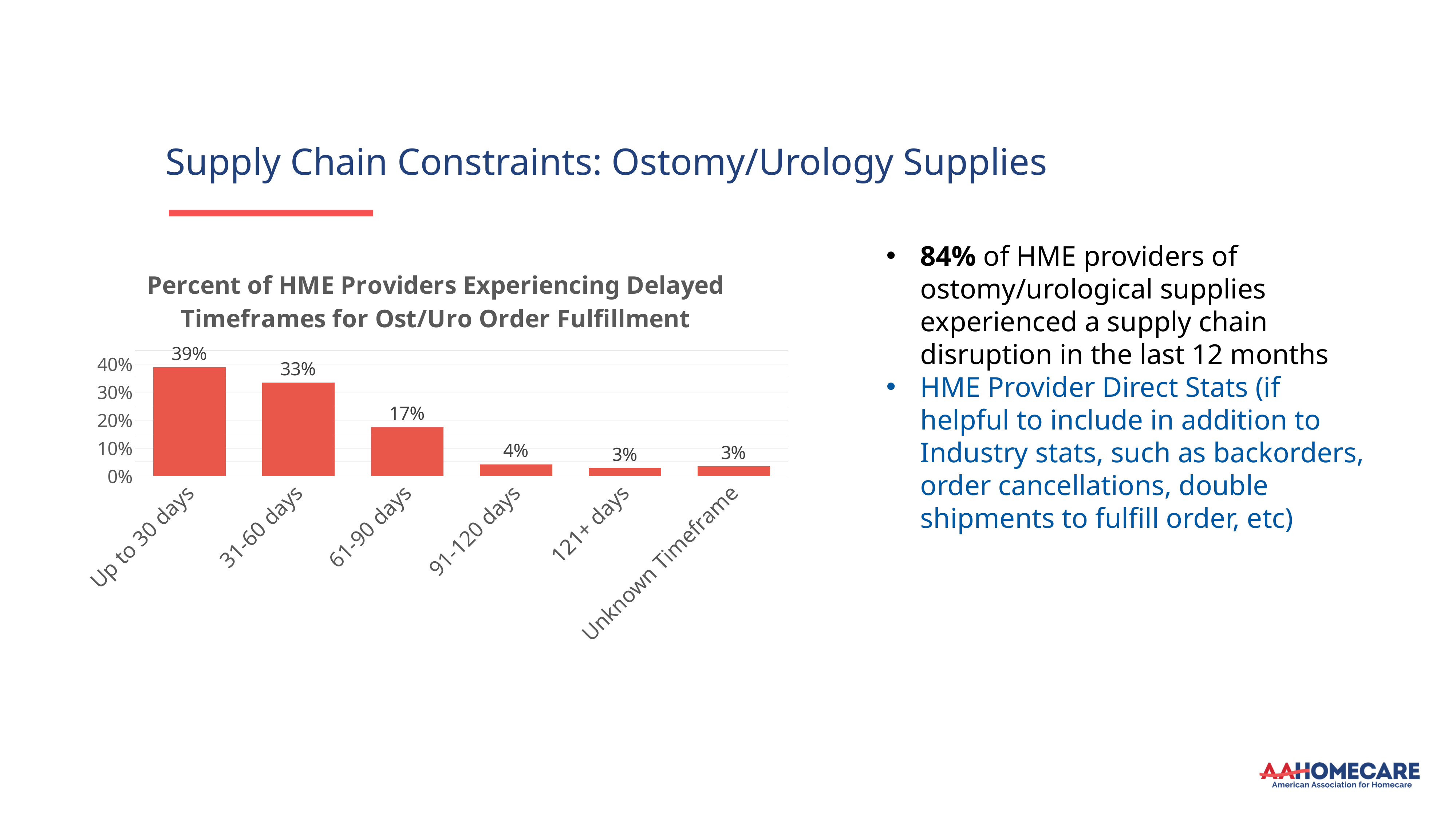
Do the values generally rise or fall moving from Up to 30 days to 121+ days? Fall What is the value shown for the 31-60 days category? 33% What is the value shown for the 91-120 days category? 4% What kind of chart is shown on the slide? Bar chart What is the value shown for the 61-90 days category? 17% What is the difference between the values for Up to 30 days and 31-60 days? 6% Which category has the highest percentage of HME providers? Up to 30 days How many categories are shown on the x axis of the chart? 6 Is the value for 31-60 days greater or less than 30%? greater Which is larger, the value for 61-90 days or the value for 91-120 days? 61-90 days What is the difference between the values for 31-60 days and 61-90 days? 16% What percent of HME providers experienced delayed timeframes of up to 30 days for Ost/Uro order fulfillment? 39%